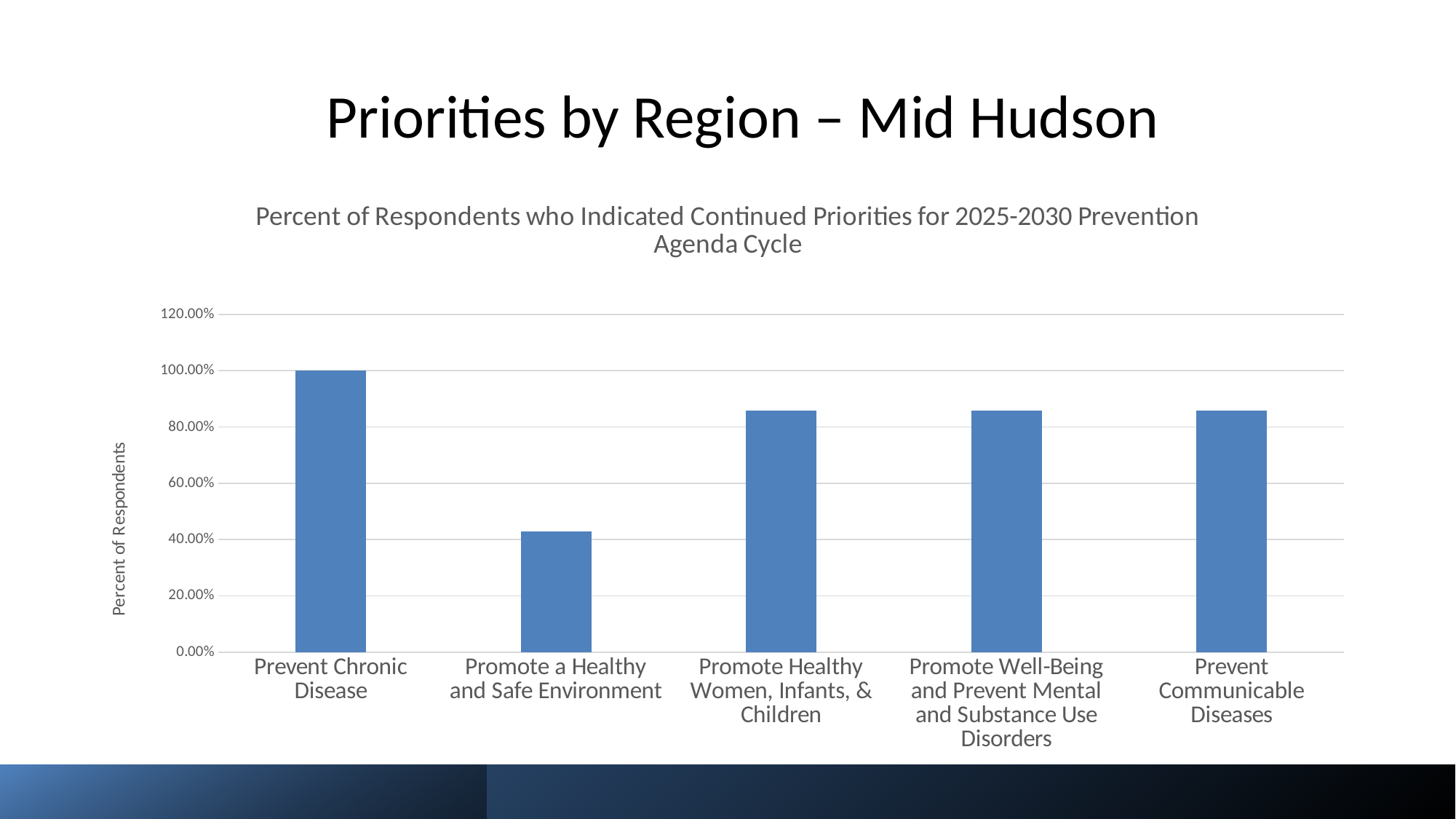
What kind of chart is shown on the slide? Bar chart How many priority categories are plotted on the chart? 5 Is the value for Prevent Communicable Diseases greater or less than 100.00%? less Is the value for Promote a Healthy and Safe Environment greater or less than 60.00%? less What is the title of the chart? Percent of Respondents who Indicated Continued Priorities for 2025-2030 Prevention Agenda Cycle Which priority has the lowest percent of respondents? Promote a Healthy and Safe Environment What is the label on the vertical axis of the chart? Percent of Respondents Which is larger: the value for Promote Well-Being and Prevent Mental and Substance Use Disorders or the value for Promote a Healthy and Safe Environment? Promote Well-Being and Prevent Mental and Substance Use Disorders Is the value for Promote Healthy Women, Infants, & Children greater or less than 60.00%? greater Which is larger: the value for Prevent Chronic Disease or the value for Promote a Healthy and Safe Environment? Prevent Chronic Disease What is the percent of respondents for Prevent Chronic Disease? 100.00% Which priority has the highest percent of respondents? Prevent Chronic Disease